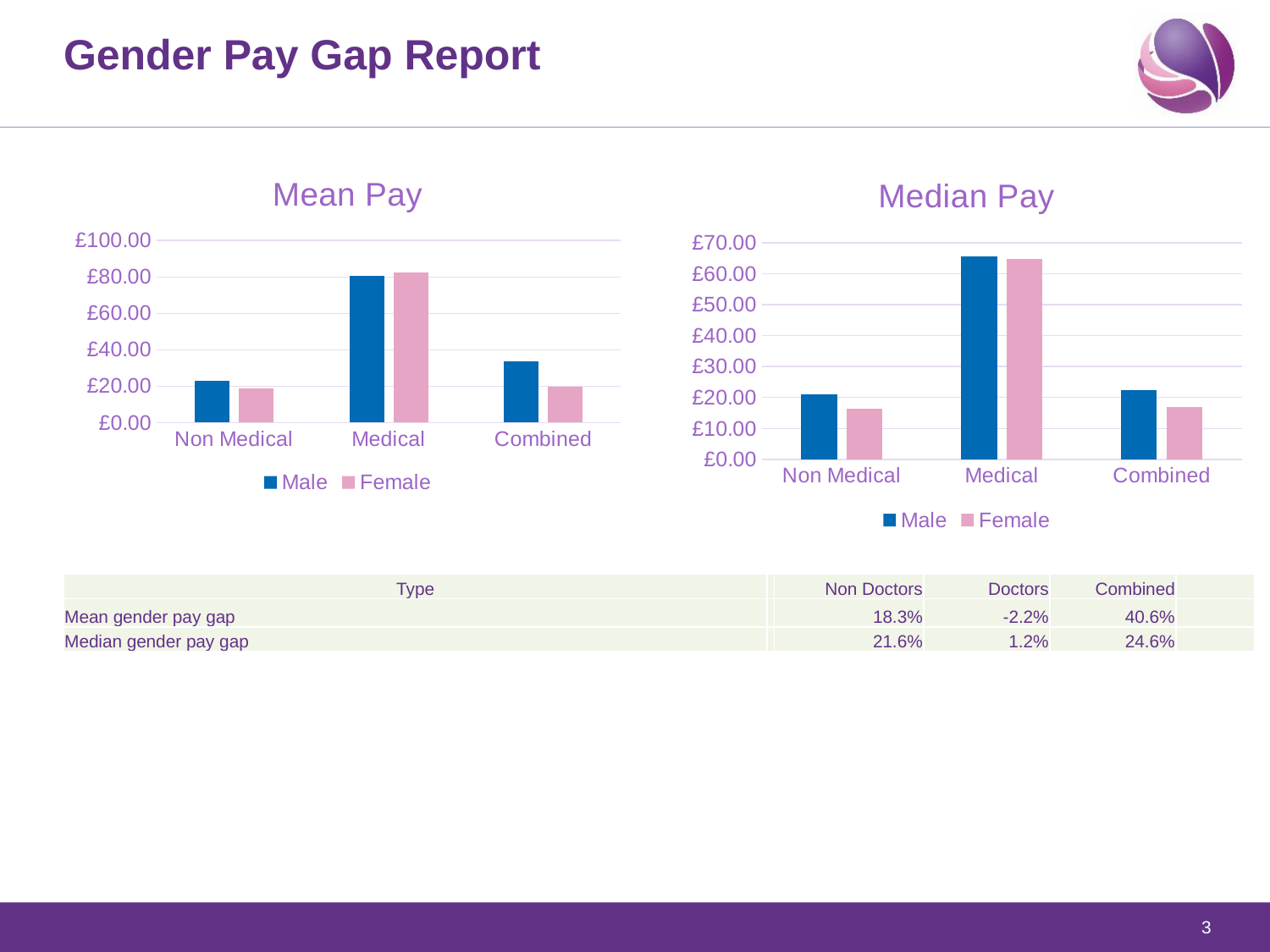
What kind of chart is the Mean Pay chart? bar chart In the Mean Pay chart, is the Male value for Non Medical larger or smaller than the Female value for Non Medical? larger How many series does the legend of the Median Pay chart list? 2 In the Median Pay chart, which colour represents the Female series? pink In the Mean Pay chart, is the Female value for Combined greater or less than £40.00? less In the Mean Pay chart, is the Male value for Medical greater or less than £60.00? greater In the Mean Pay chart, which category has the highest Male value? Medical In the Mean Pay chart, which category has the lowest Male value? Non Medical How many categories are shown on the x axis of the Mean Pay chart? 3 In the Median Pay chart, is the Male value for Medical greater or less than £60.00? greater In the Median Pay chart, which category has the highest Female value? Medical In the Median Pay chart, is the Male value for Combined larger or smaller than the Female value for Combined? larger